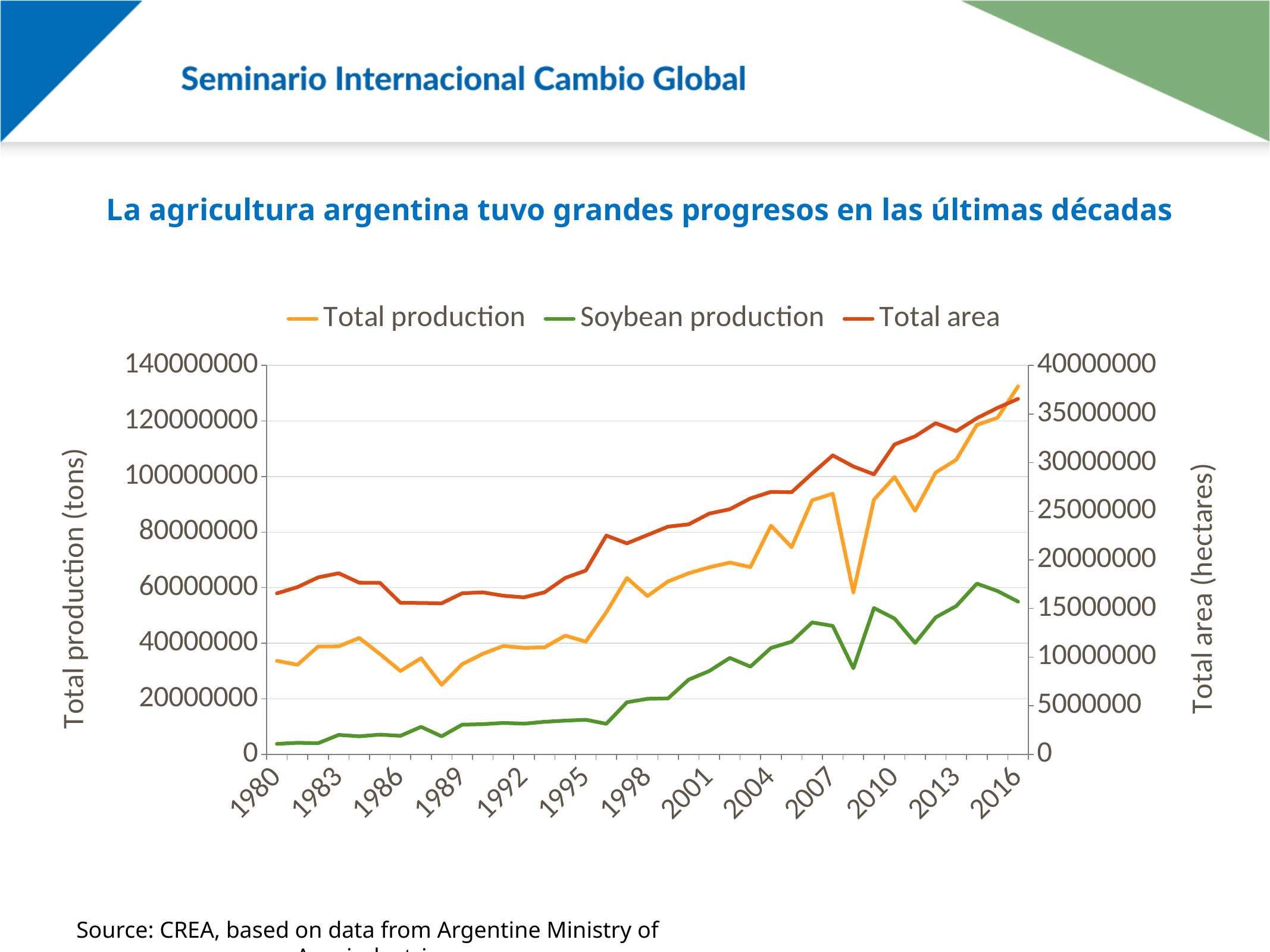
Does Soybean production generally rise or fall from 1980 to 2016? Rise Is the value for Soybean production in 1980 greater or less than 20000000? less Is the value for Total production in 2016 greater or less than 120000000? greater What kind of chart is shown on the slide? Line chart Which series are listed in the chart legend? Total production, Soybean production, Total area How many series does the legend list? 3 In 2016, which is larger: Total production or Soybean production? Total production What is the title of the left vertical axis? Total production (tons) Is the value for Total production in 1980 greater or less than 40000000? less How many year labels are shown on the x axis? 13